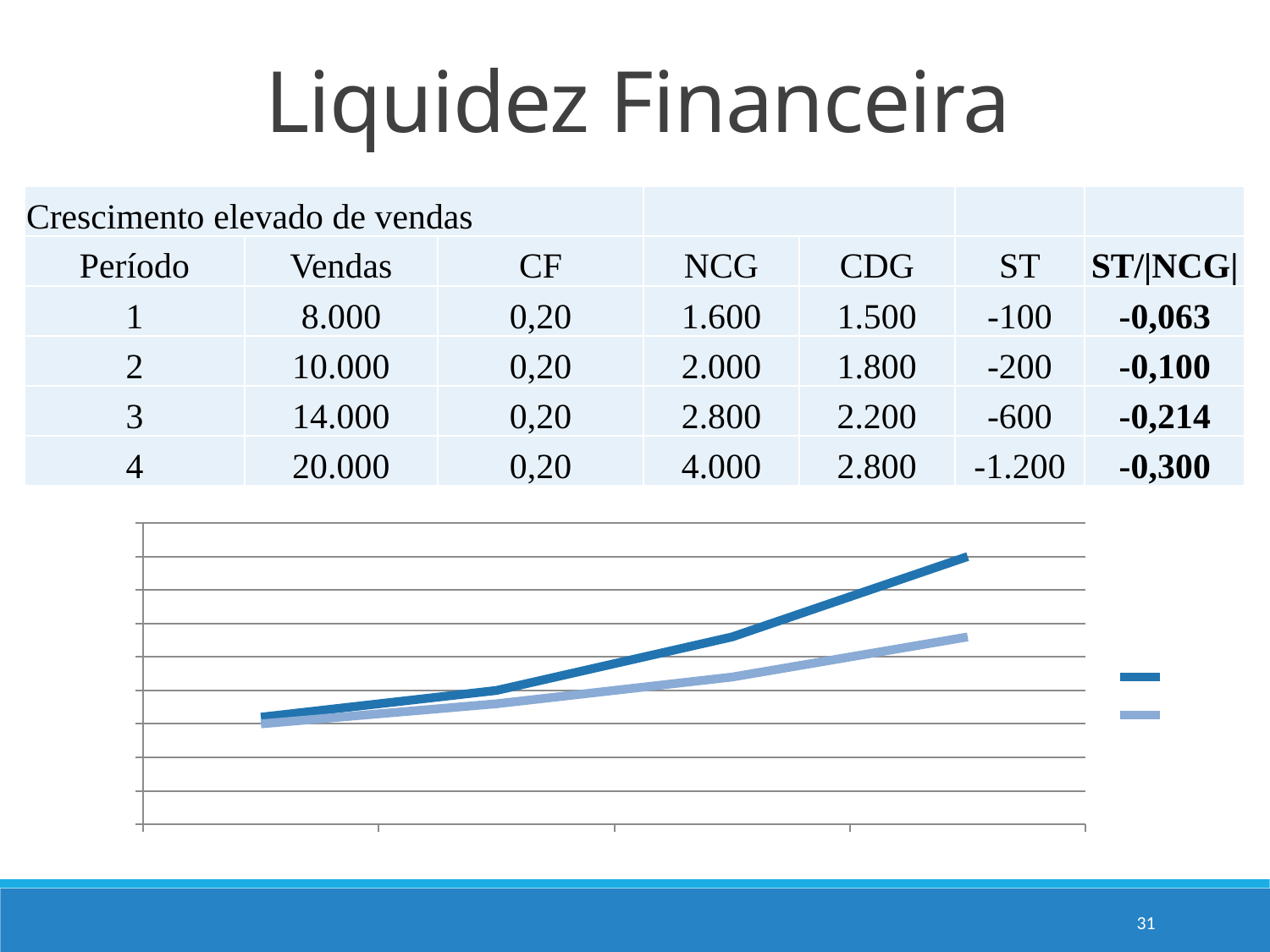
What kind of chart is shown on the slide? line chart How many data points does each line in the chart have? 4 At the rightmost point of the chart, which line is higher, the dark blue line or the light blue line? the dark blue line Which line in the chart ends at the lowest value at the rightmost point? the light blue line How many series does the legend of the chart list? 2 What colours are the two lines in the chart? dark blue and light blue Which line in the chart reaches the highest value? the dark blue line Do the values of the dark blue line rise or fall from left to right along the x axis? rise Do the values of the light blue line rise or fall from left to right along the x axis? rise Does the gap between the two lines widen or narrow from left to right? widen